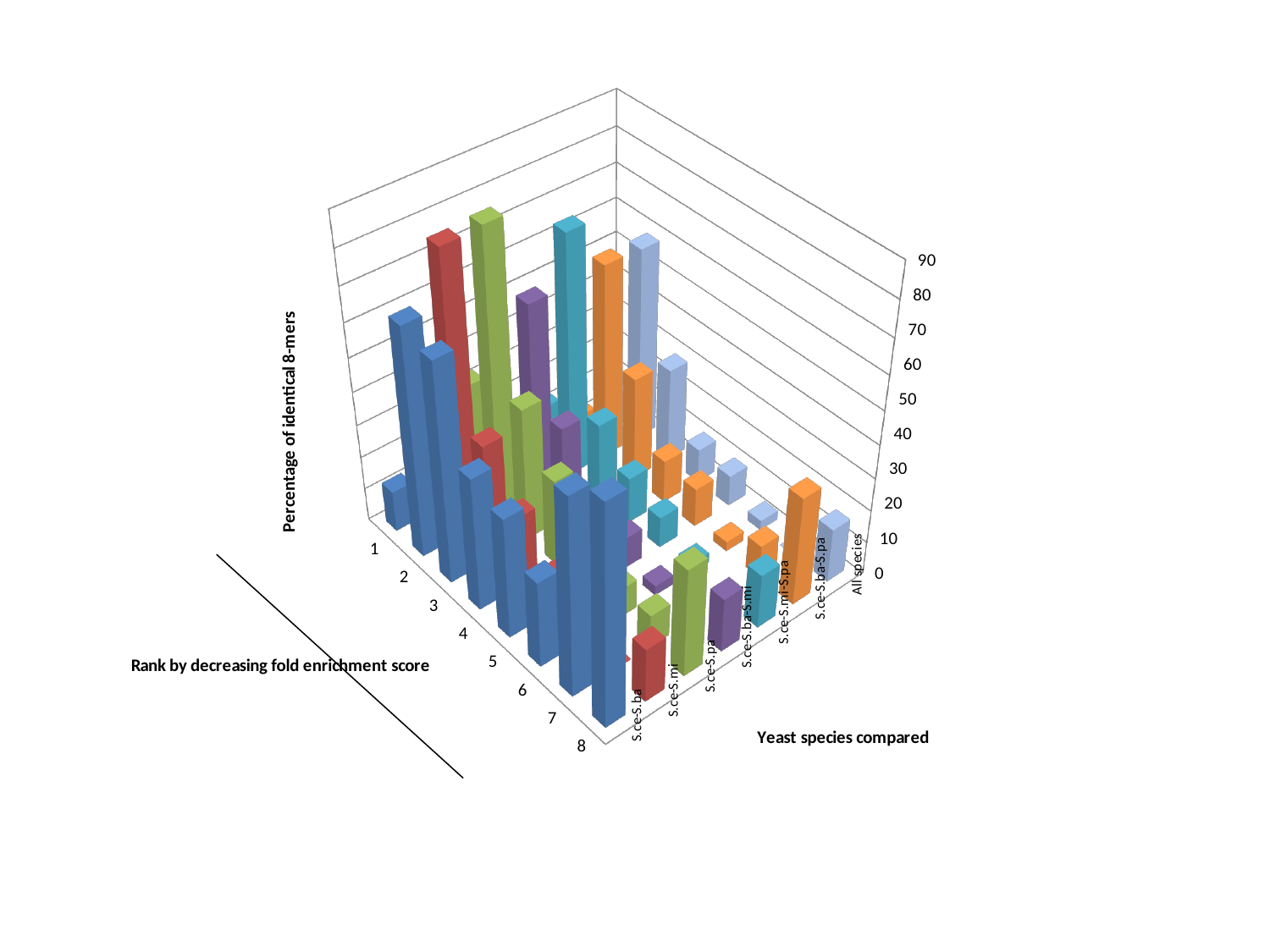
What is the highest value shown on the vertical axis? 90 What is the title of the vertical axis? Percentage of identical 8-mers Which yeast species comparison is listed last on the 'Yeast species compared' axis? All species How many rank categories are shown along the 'Rank by decreasing fold enrichment score' axis? 8 Which yeast species comparison is listed first on the 'Yeast species compared' axis? S.ce-S.ba What kind of chart is shown on the slide? 3D bar chart How many yeast species comparisons are shown along the 'Yeast species compared' axis? 7